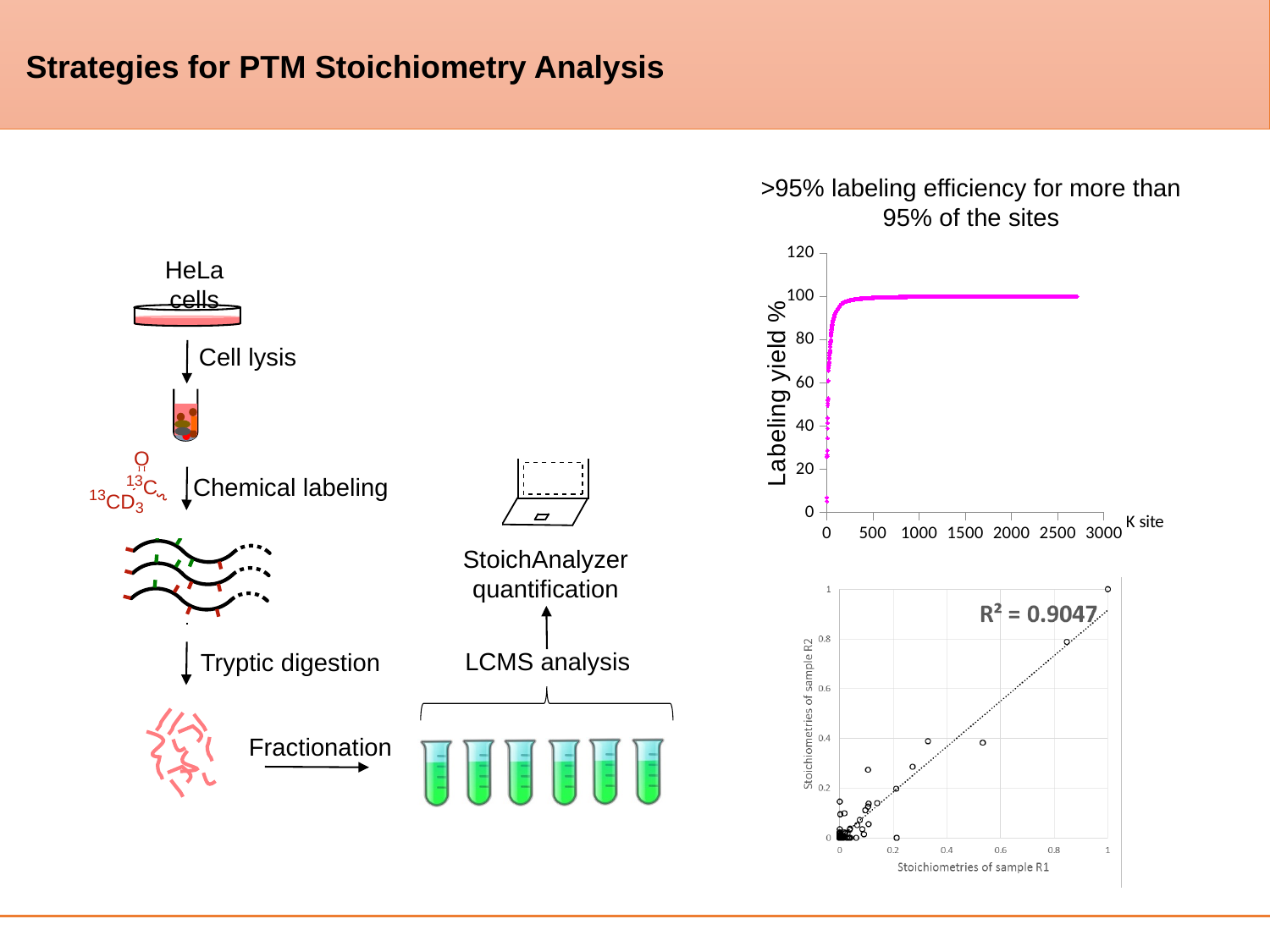
In the top-right chart, what is the label of the y axis? Labeling yield % In the top-right chart, what is the label of the x axis? K site In the top-right chart, what is the highest value shown on the y axis? 120 In the bottom-right chart, what is the label of the x axis? Stoichiometries of sample R1 In the top-right chart, what is the highest value shown on the x axis? 3000 What kind of chart is the bottom-right chart comparing stoichiometries of sample R1 and sample R2? Scatter chart In the top-right chart, is the labeling yield for most K sites greater or less than 80? greater What kind of chart is the top-right chart with the y axis labelled 'Labeling yield %'? Scatter chart In the top-right chart, do the labeling yield values rise or fall as the K site number increases along the x axis? Rise How many charts are shown on the slide? 2 In the bottom-right chart, do the sample R2 stoichiometries rise or fall as the sample R1 stoichiometries increase along the x axis? Rise What R² value is printed on the bottom-right chart? R² = 0.9047